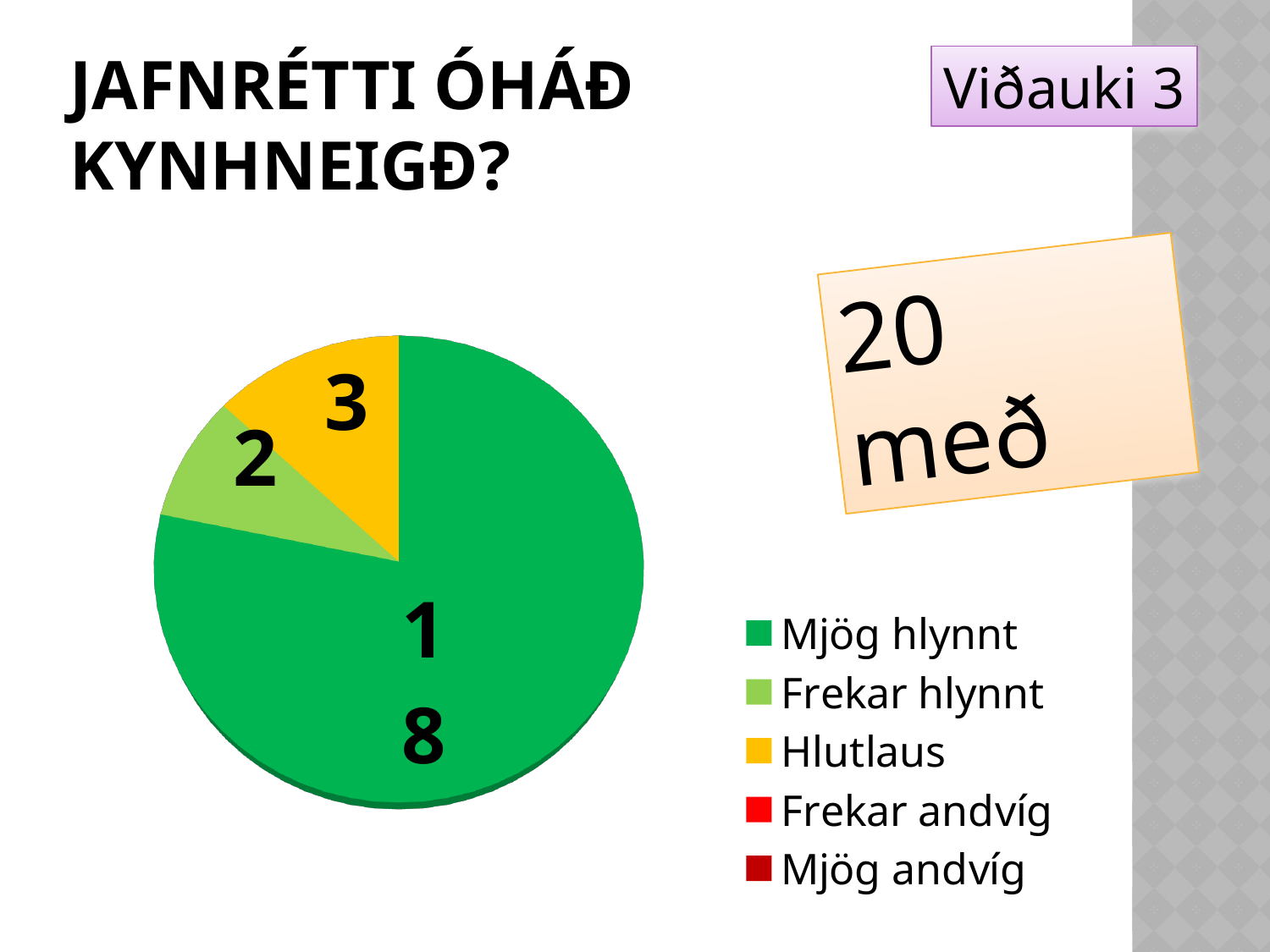
What is the difference between the Mjög hlynnt and Hlutlaus values? 15 What colour is the Hlutlaus slice? yellow Which is larger, the Hlutlaus slice or the Frekar hlynnt slice? Hlutlaus What kind of chart is shown on the slide? pie chart Which category has the largest slice of the pie? Mjög hlynnt What is the value of the Hlutlaus slice? 3 What is the difference between the Hlutlaus and Frekar hlynnt values? 1 How many entries does the legend list? 5 What is the value of the Frekar hlynnt slice? 2 How many slices with data labels are visible in the pie? 3 Which of the visible slices is the smallest? Frekar hlynnt What is the value of the Mjög hlynnt slice? 18